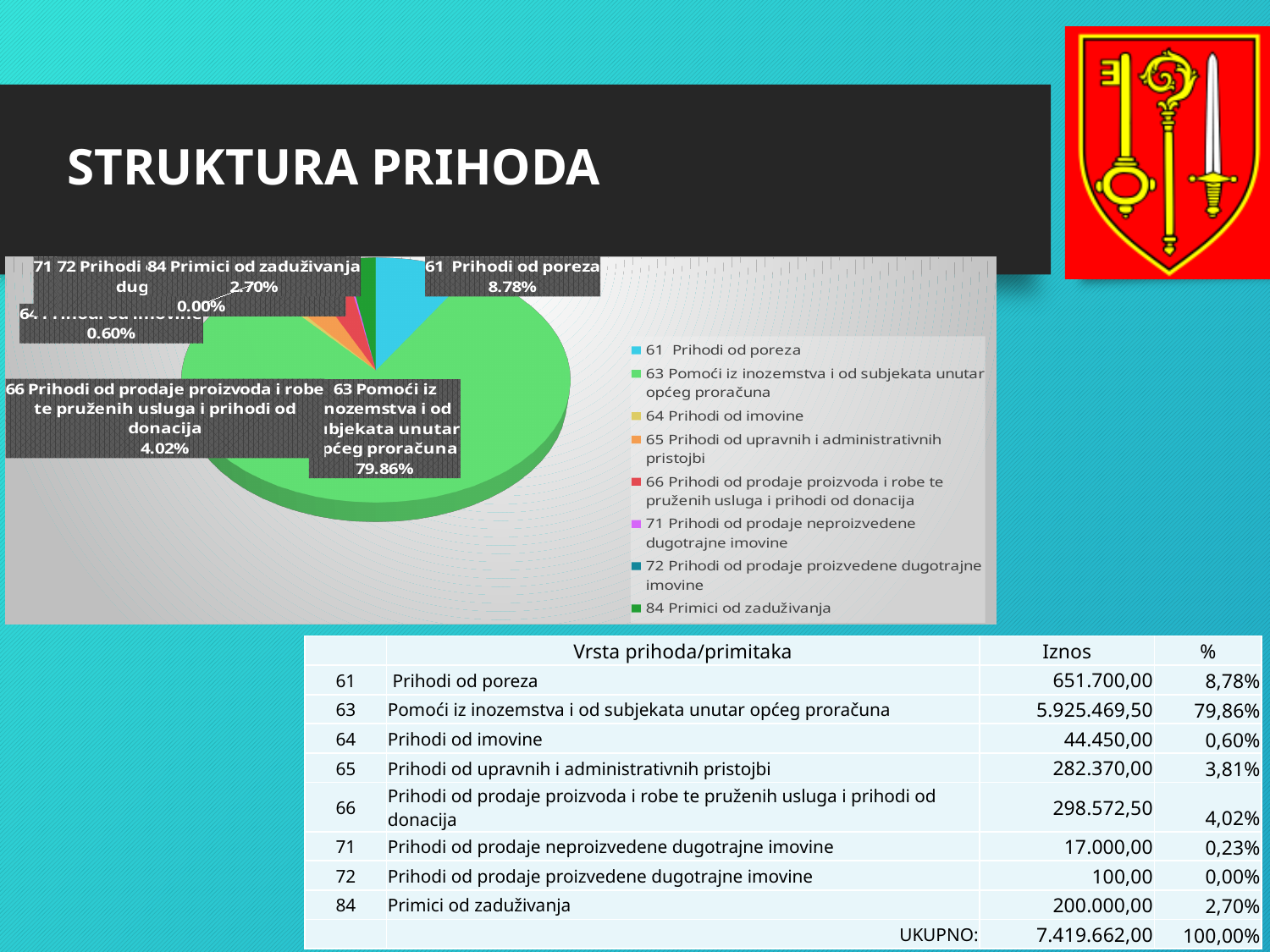
What share of the pie does '64 Prihodi od imovine' have? 0.60% What share of the pie does '66 Prihodi od prodaje proizvoda i robe te pruženih usluga i prihodi od donacija' have? 4.02% What share of the pie does '63 Pomoći iz inozemstva i od subjekata unutar općeg proračuna' have? 79.86% What is the title of the slide containing the pie chart? STRUKTURA PRIHODA What kind of chart is shown on the slide? pie chart What is the difference in percentage points between '61 Prihodi od poreza' and '84 Primici od zaduživanja'? 6.08% How many entries does the chart legend list? 8 What share of the pie does '84 Primici od zaduživanja' have? 2.70% Which slice is larger: '61 Prihodi od poreza' or '84 Primici od zaduživanja'? 61 Prihodi od poreza What share of the pie does '61 Prihodi od poreza' have? 8.78% Which slice is larger: '66 Prihodi od prodaje proizvoda i robe te pruženih usluga i prihodi od donacija' or '64 Prihodi od imovine'? 66 Prihodi od prodaje proizvoda i robe te pruženih usluga i prihodi od donacija Which category has the largest slice of the pie? 63 Pomoći iz inozemstva i od subjekata unutar općeg proračuna